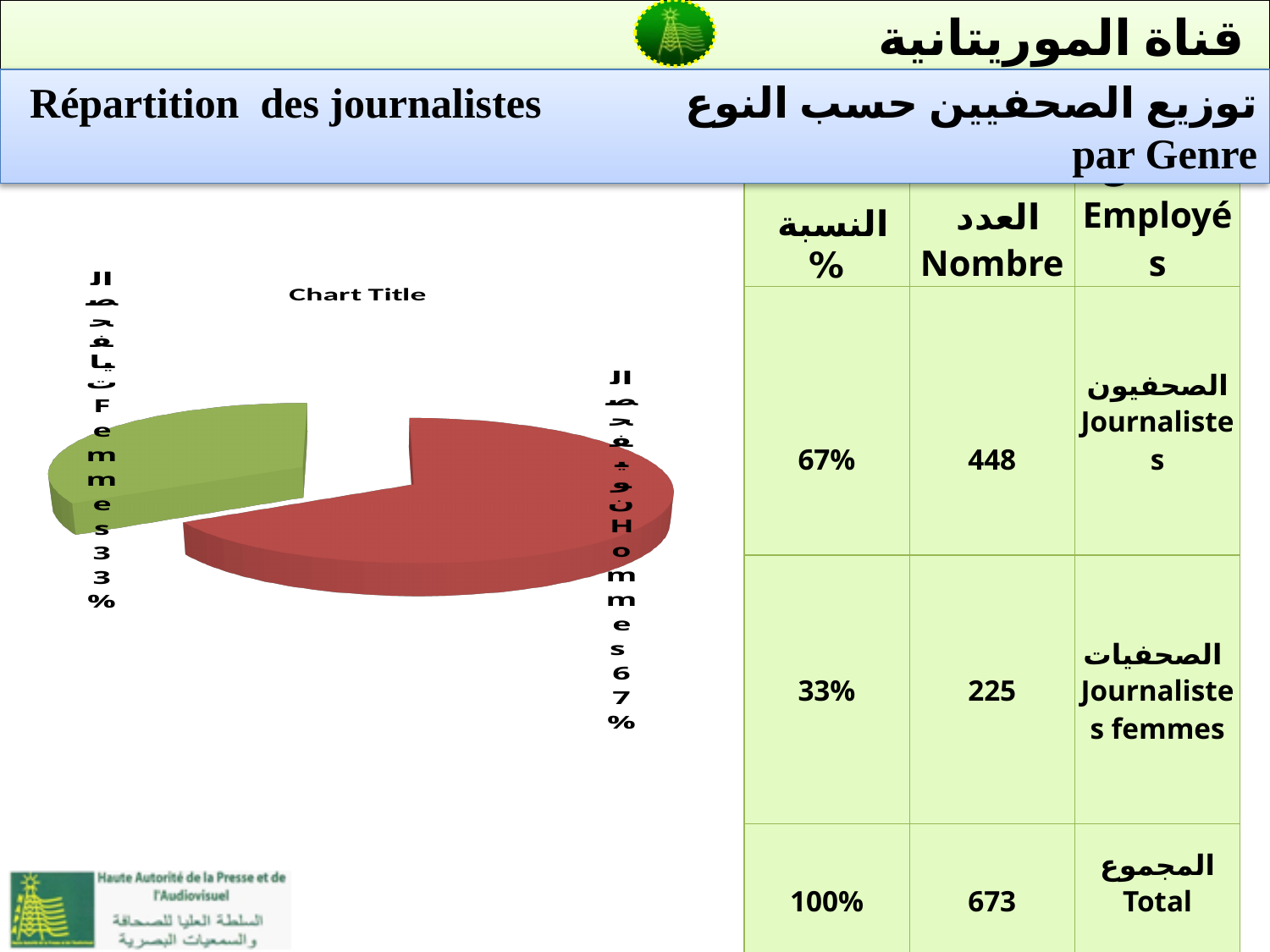
What share of the pie does the Hommes slice represent? 67% Which slice of the pie chart is the largest? Hommes Which slice of the pie chart is the smallest? Femmes Is the share for Femmes greater or less than 50%? less What is the title printed above the pie chart? Chart Title Which slice is larger, Hommes or Femmes? Hommes What share of the pie does the Femmes slice represent? 33% What is the difference in percentage points between the Hommes and Femmes slices? 34 How many slices does the pie chart have? 2 What colour is the Femmes slice of the pie chart? green What kind of chart is shown on the slide? pie chart